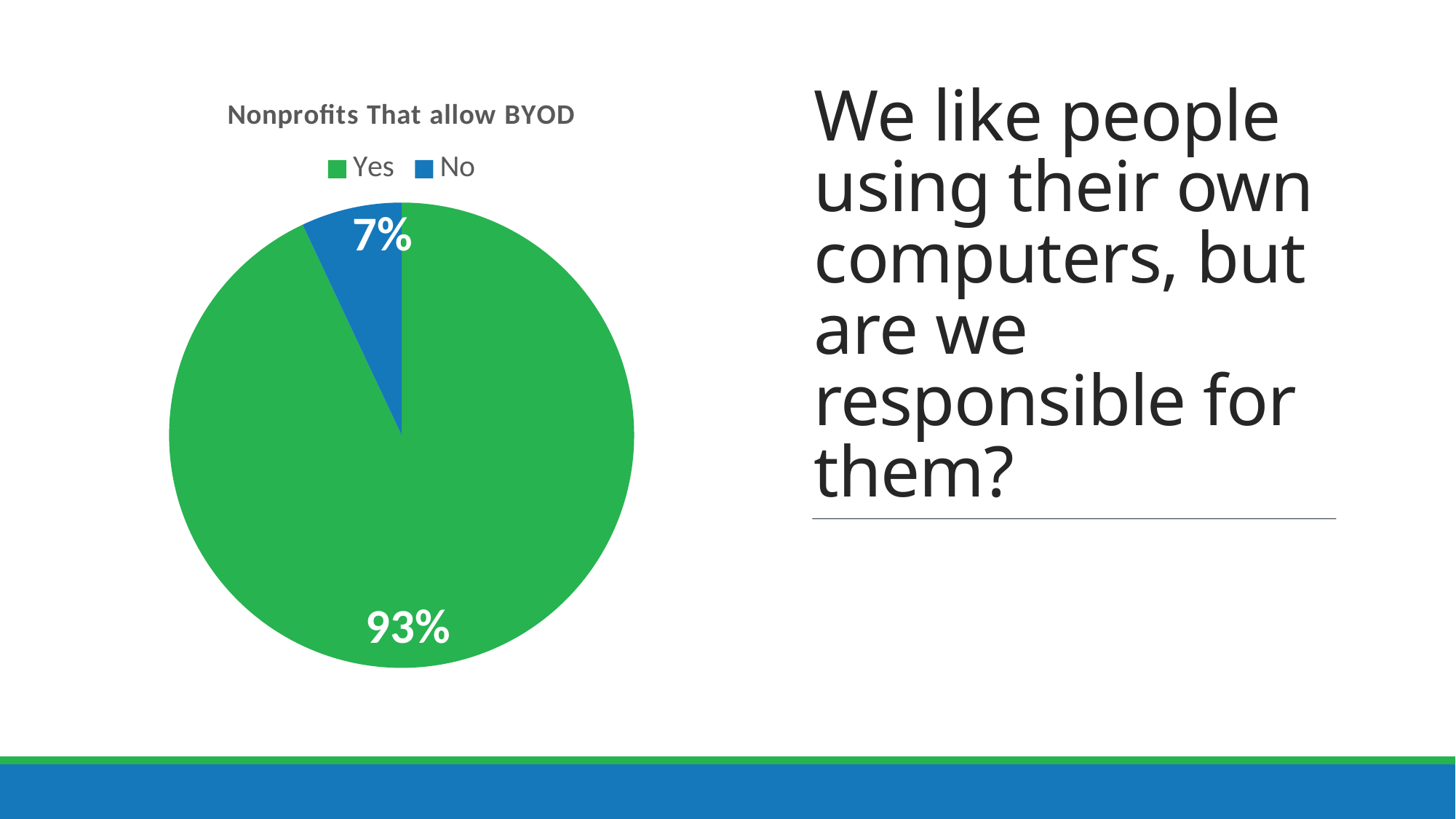
How many slices does the pie chart have? 2 What colour is the Yes slice? green What is the title of the chart? Nonprofits That allow BYOD What percentage of nonprofits allow BYOD (Yes)? 93% How many entries does the legend list? 2 What is the difference in percentage points between the Yes and No slices? 86 What kind of chart is shown on the slide? pie chart What percentage of nonprofits do not allow BYOD (No)? 7% Which is larger, the Yes slice or the No slice? Yes What share of the pie does the No slice represent? 7% Which category has the smallest share of the pie? No Which category has the largest share of the pie? Yes